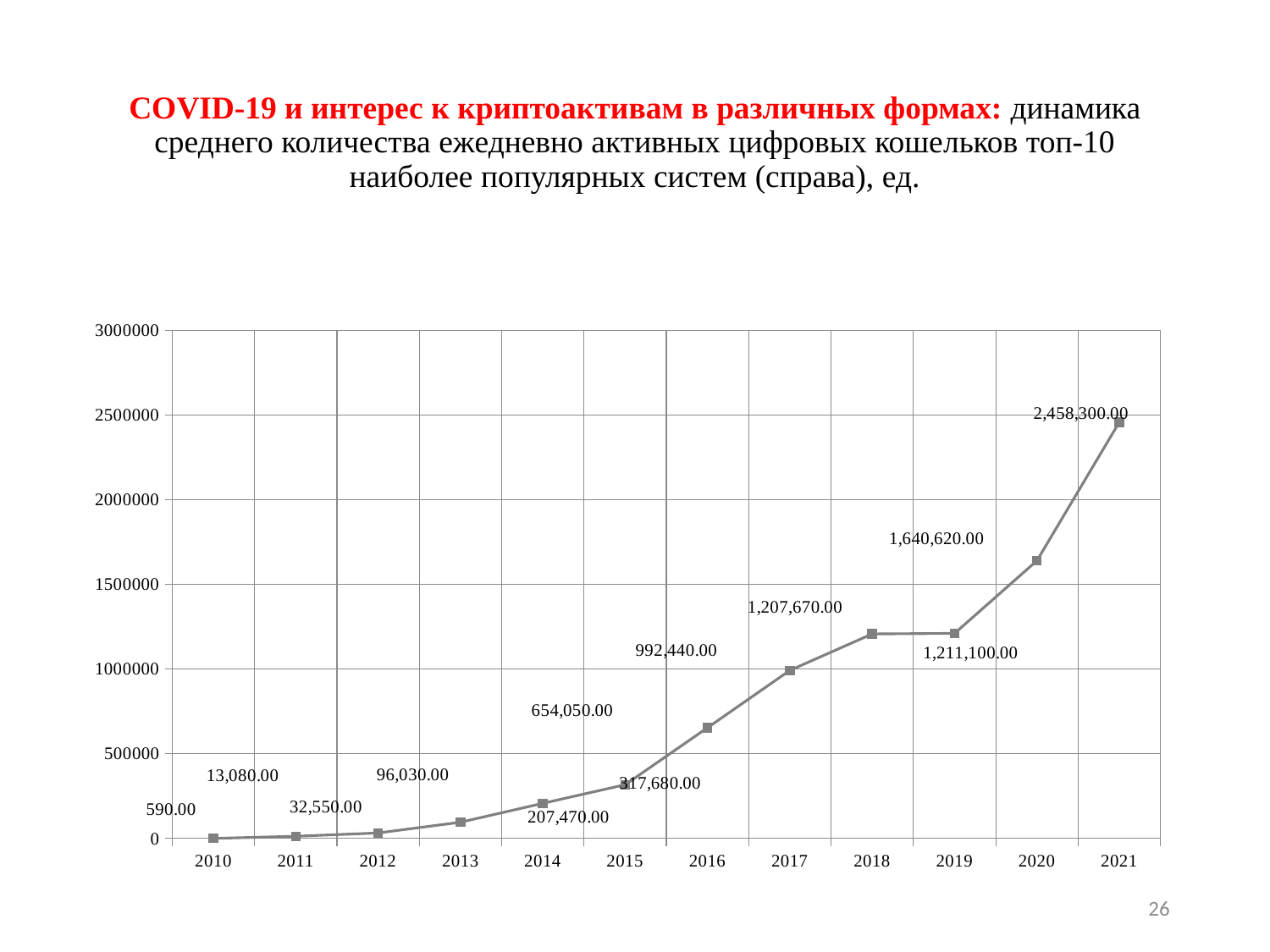
What is the value for 2021 in the chart? 2,458,300.00 Do the values generally rise or fall from 2010 to 2021? rise How many years are plotted on the x axis of the chart? 12 Is the value for 2020 greater or less than 1500000? greater Which is larger, the value for 2016 or the value for 2017? 2017 What is the difference between the values for 2021 and 2020? 817,680.00 Which year has the highest value in the chart? 2021 What is the value for 2017 in the chart? 992,440.00 Which year has the lowest value in the chart? 2010 What is the value for 2020 in the chart? 1,640,620.00 What type of chart is shown on the slide? line chart What is the value for 2010 in the chart? 590.00